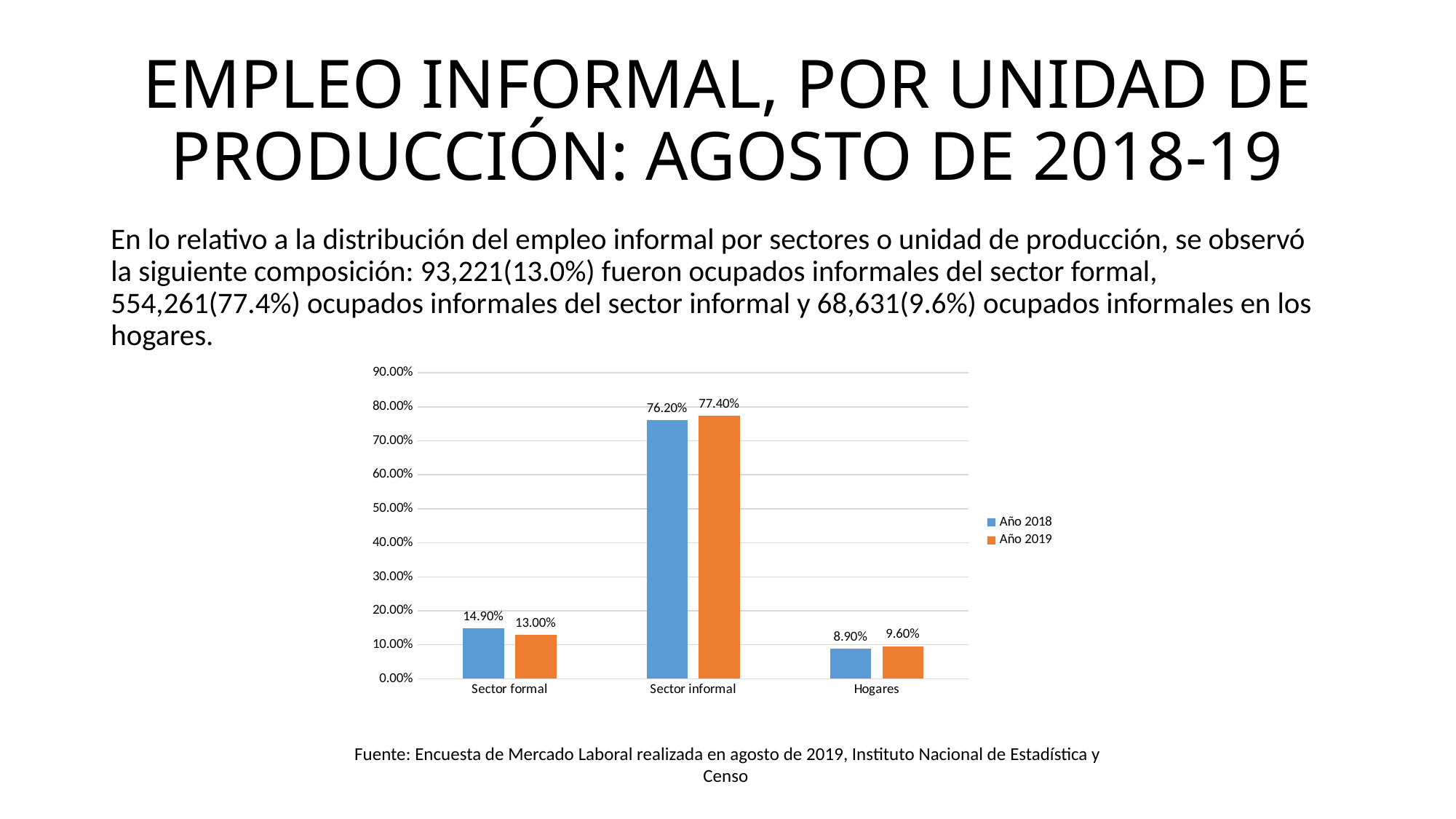
Is the value for Sector informal in Año 2018 greater or less than 70.00%? greater What is the value for Sector formal in Año 2018? 14.90% What kind of chart is shown on the slide? Bar chart How many series does the legend list? 2 Which category has the lowest value in Año 2018? Hogares Which is larger for Hogares: the Año 2018 value or the Año 2019 value? Año 2019 What is the difference between the Año 2019 and Año 2018 values for Sector informal? 1.20% What is the value for Hogares in Año 2018? 8.90% How many categories are shown on the x axis? 3 Which category has the highest value in Año 2019? Sector informal What is the value for Sector informal in Año 2019? 77.40% What is the difference between the Año 2018 and Año 2019 values for Sector formal? 1.90%